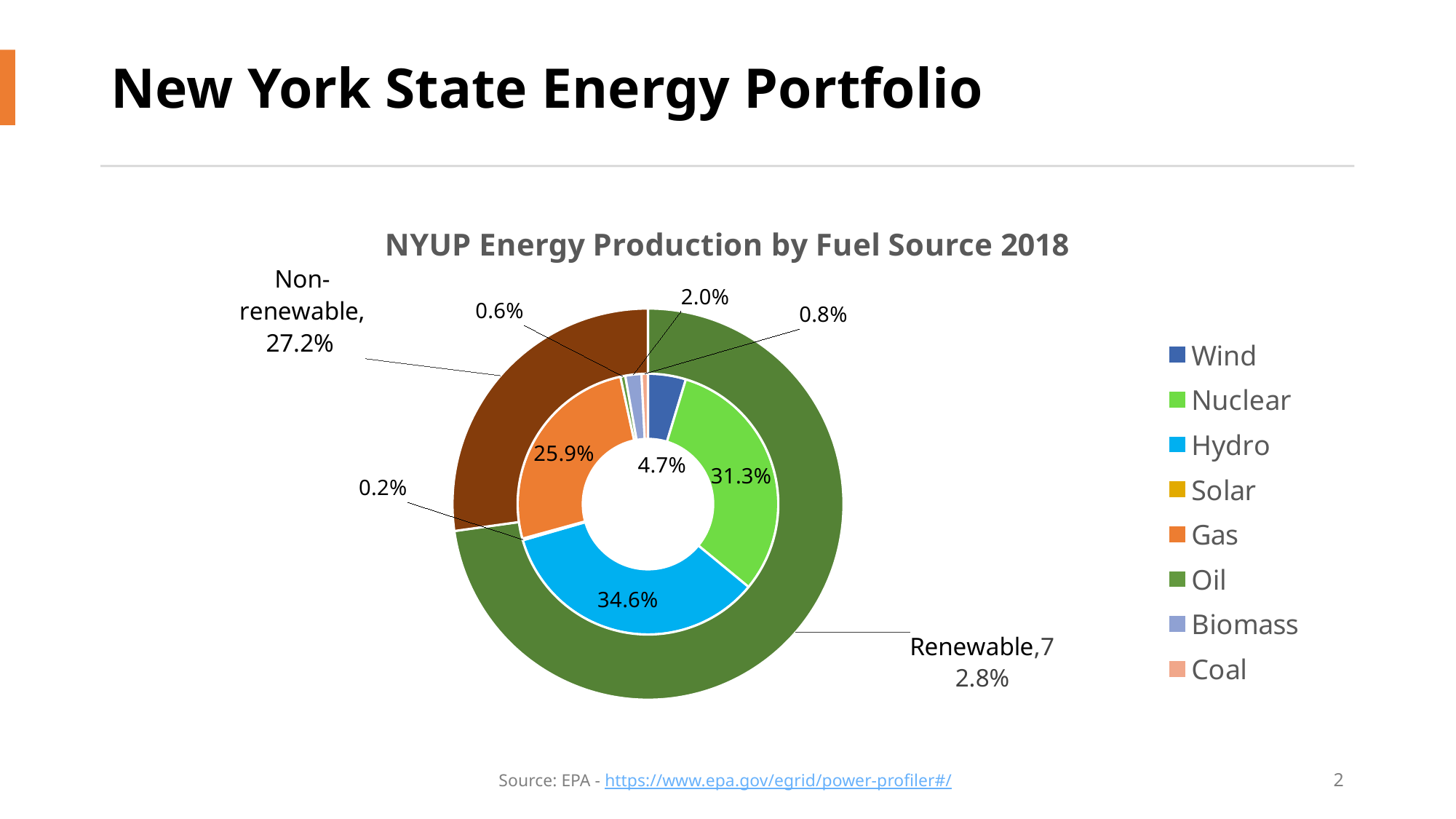
What share of NYUP energy production in 2018 came from Gas? 25.9% What share of NYUP energy production in 2018 came from Wind? 4.7% What share of NYUP energy production in 2018 came from Nuclear? 31.3% What share of NYUP energy production in 2018 came from Hydro? 34.6% What percentage of NYUP energy production is labelled as Renewable in the outer ring? 72.8% By how many percentage points does the Renewable share exceed the Non-renewable share? 45.6 percentage points What is the title of the chart on the slide? NYUP Energy Production by Fuel Source 2018 What percentage of NYUP energy production is labelled as Non-renewable in the outer ring? 27.2% How many fuel sources are listed in the chart legend? 8 Which is larger, the share for Nuclear or the share for Gas? Nuclear By how many percentage points does the Hydro share exceed the Nuclear share? 3.3 percentage points Which fuel source has the largest share of NYUP energy production in 2018? Hydro